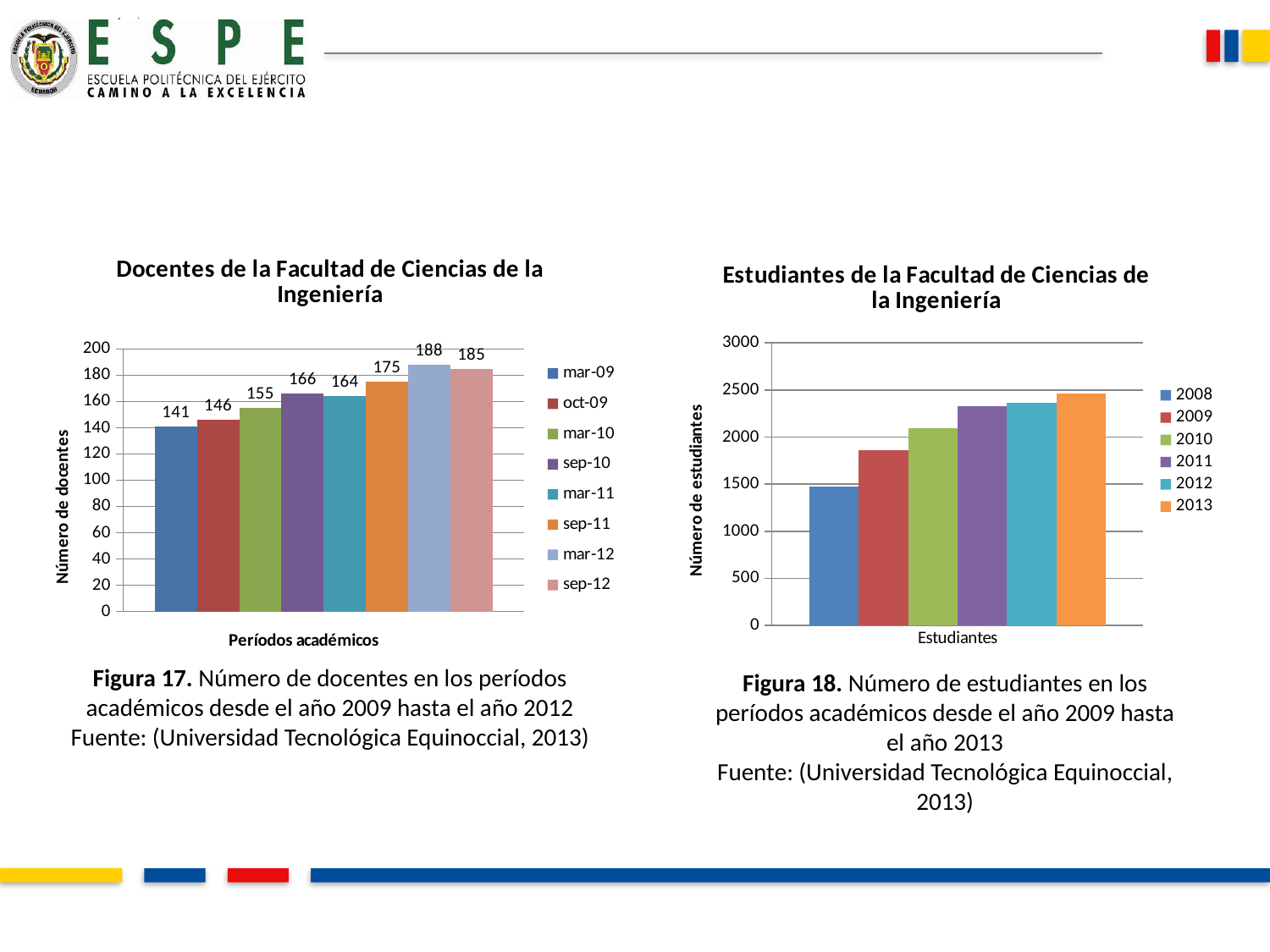
In the 'Docentes de la Facultad de Ciencias de la Ingeniería' chart, which period has the lowest number of docentes? mar-09 In the 'Docentes de la Facultad de Ciencias de la Ingeniería' chart, which period has the highest number of docentes? mar-12 In the 'Docentes de la Facultad de Ciencias de la Ingeniería' chart, what is the difference between the values for mar-12 and mar-09? 47 What kind of chart is the 'Estudiantes de la Facultad de Ciencias de la Ingeniería' chart? bar chart In the 'Estudiantes de la Facultad de Ciencias de la Ingeniería' chart, is the value for 2010 greater or less than 2000? greater In the 'Estudiantes de la Facultad de Ciencias de la Ingeniería' chart, which year has the highest number of students? 2013 In the 'Docentes de la Facultad de Ciencias de la Ingeniería' chart, what is the value for sep-11? 175 In the 'Docentes de la Facultad de Ciencias de la Ingeniería' chart, what is the value for mar-09? 141 How many series does the legend of the 'Docentes de la Facultad de Ciencias de la Ingeniería' chart list? 8 In the 'Docentes de la Facultad de Ciencias de la Ingeniería' chart, which is larger, the value for sep-10 or the value for mar-11? sep-10 In the 'Estudiantes de la Facultad de Ciencias de la Ingeniería' chart, is the value for 2008 greater or less than 1500? less In the 'Estudiantes de la Facultad de Ciencias de la Ingeniería' chart, do the values rise or fall from 2008 to 2013? rise